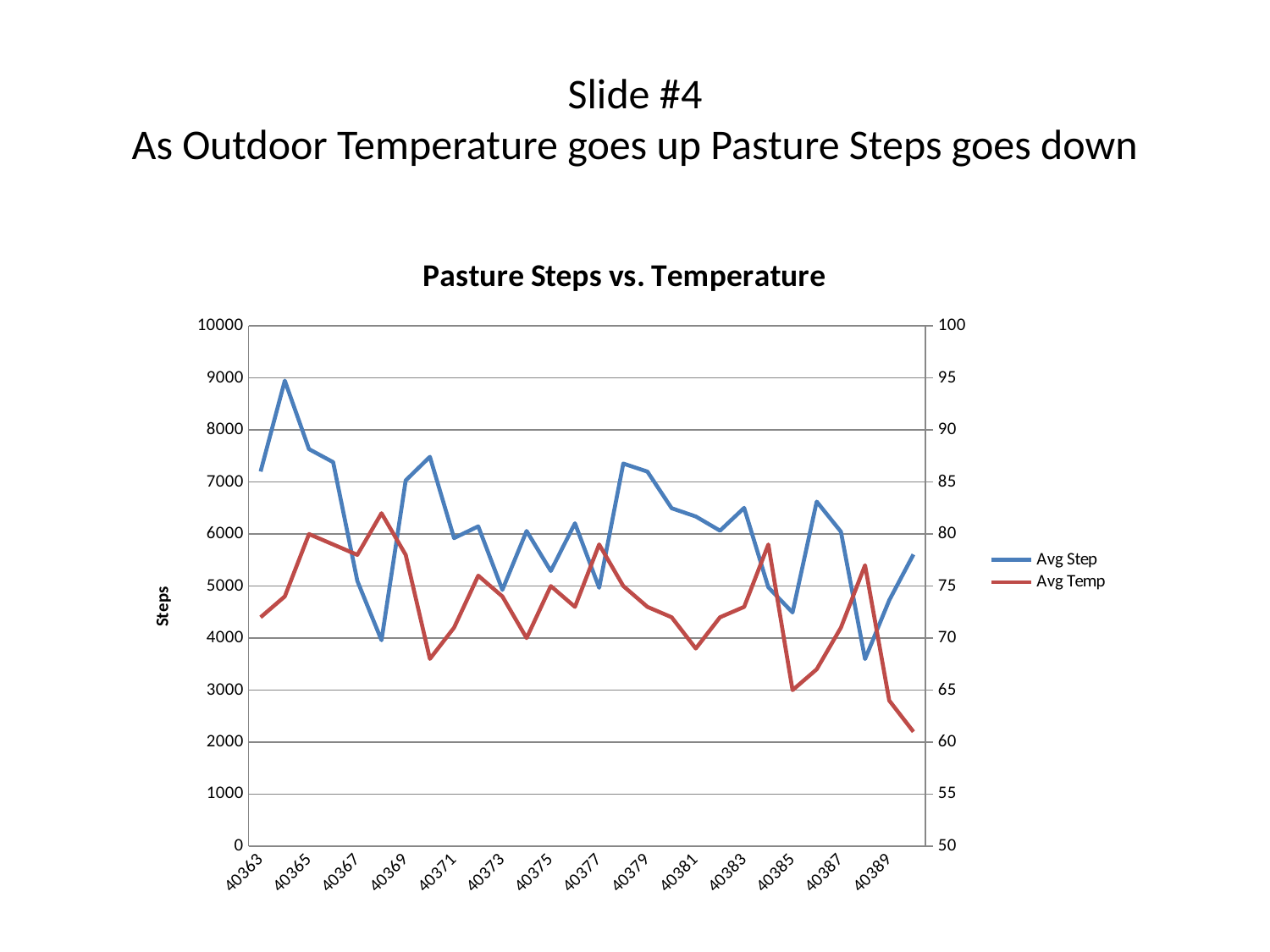
Is the Avg Temp value at 40385 greater or less than 70? less What is the title of the chart? Pasture Steps vs. Temperature Overall, does the Avg Temp series rise or fall from the left end of the x axis to the right end? fall At which x-axis point does the Avg Step series reach its highest value? 40364 What are the two series named in the legend? Avg Step and Avg Temp Is the Avg Step value at 40364 greater or less than 8000? greater How many series does the legend list? 2 What kind of chart is shown on the slide? line chart Is the Avg Step value at 40388 greater or less than 4000? less At which x-axis point does the Avg Temp series reach its lowest value? 40390